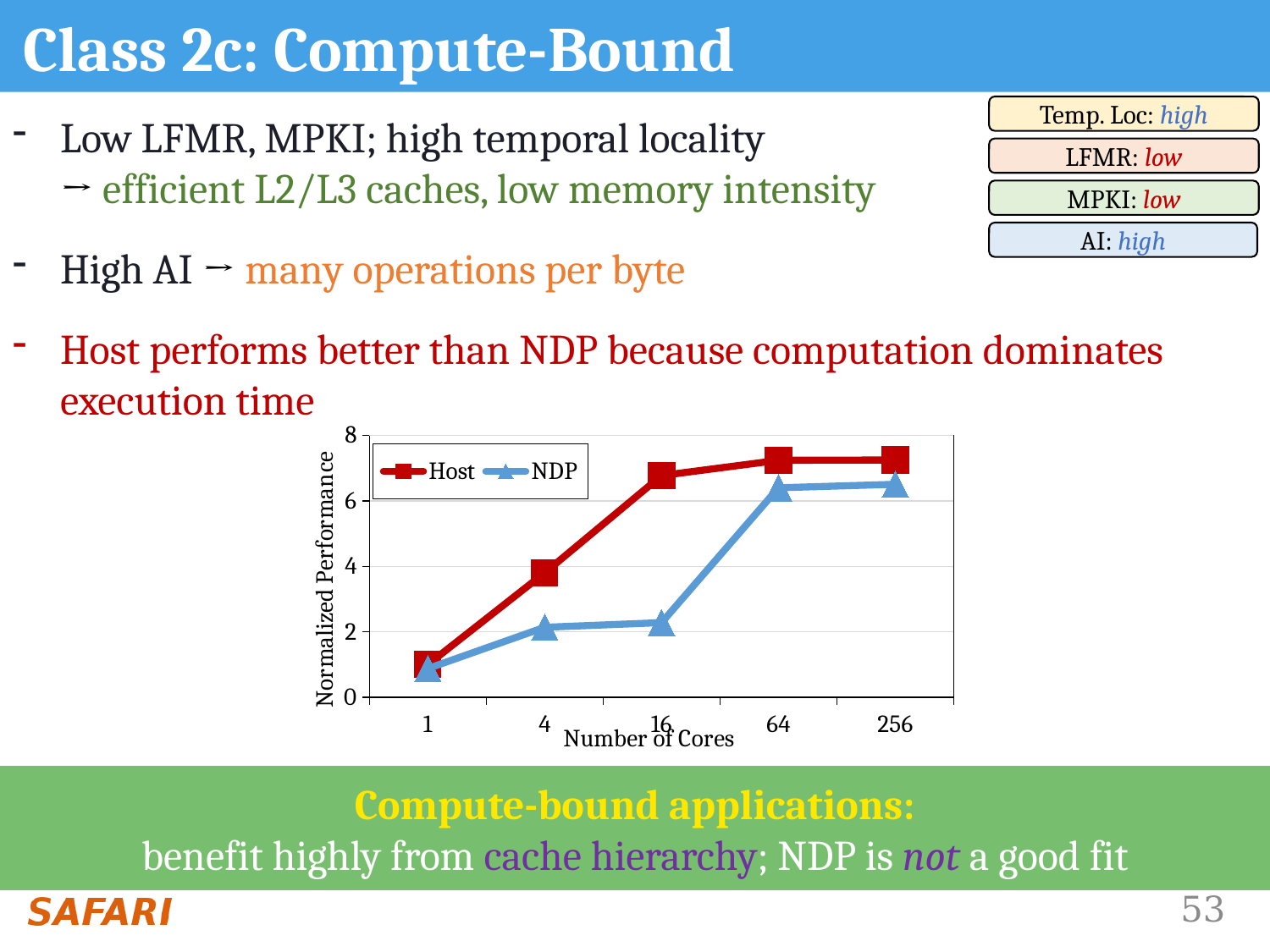
What is the label of the chart's x axis? Number of Cores At 4 cores, which series has the higher normalized performance, Host or NDP? Host Is the NDP value at 16 cores greater or less than 4? less Is the Host value at 16 cores greater or less than 6? greater Does the Host series rise or fall as the number of cores increases? rise At 16 cores, which series has the higher normalized performance, Host or NDP? Host Is the Host value at 4 cores greater or less than 2? greater What is the label of the chart's y axis? Normalized Performance How many core counts are plotted along the x axis of the chart? 5 How many series does the chart's legend list? 2 What kind of chart is shown on the slide? line chart